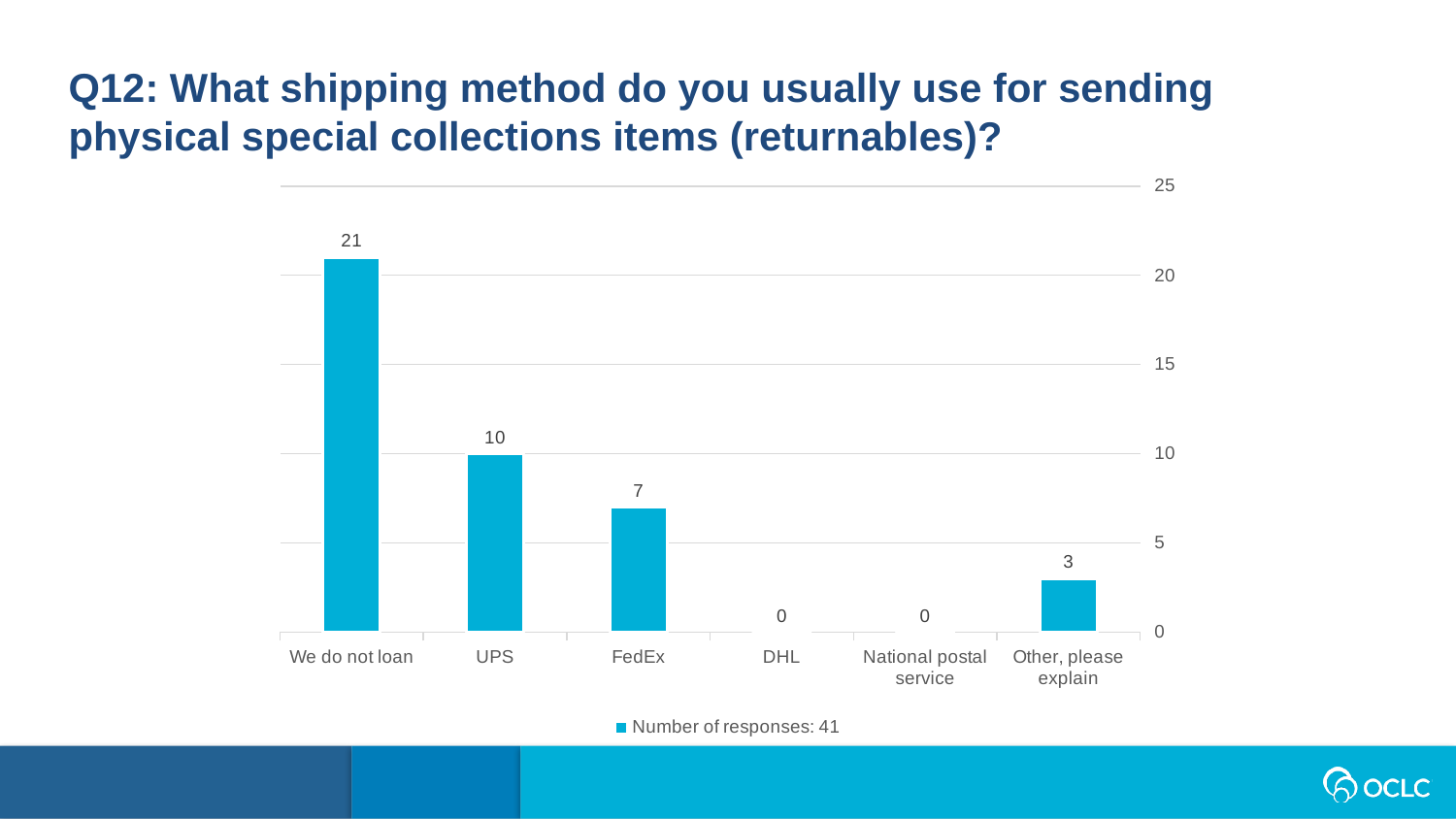
Is the value for 'We do not loan' greater or less than 20? greater What kind of chart is shown on the slide? Bar chart What is the number of responses for 'Other, please explain'? 3 What is the number of responses for DHL? 0 What is the difference in responses between 'We do not loan' and UPS? 11 How many series does the legend list? 1 What is the number of responses for FedEx? 7 Which category has the highest number of responses? We do not loan What is the legend entry for the series? Number of responses: 41 Which has more responses, UPS or FedEx? UPS How many categories are shown on the x axis? 6 What is the number of responses for UPS? 10